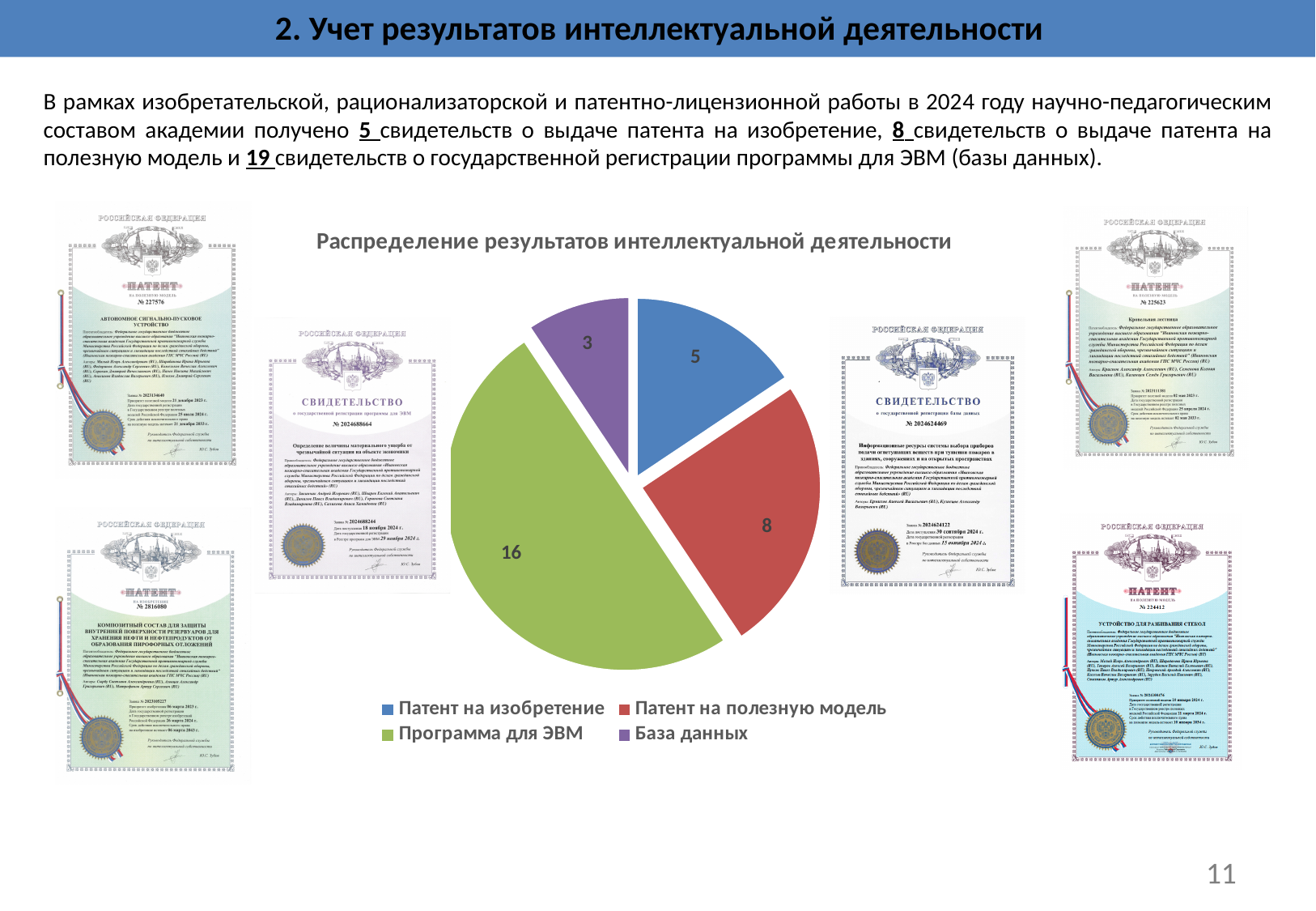
Which category has the smallest slice? База данных Which is larger, Патент на изобретение or Патент на полезную модель? Патент на полезную модель What kind of chart is shown on the slide? Pie chart What share of the pie does Программа для ЭВМ represent? 50% What is the value for Программа для ЭВМ? 16 What is the value for Патент на полезную модель? 8 What is the value for Патент на изобретение? 5 Which category has the largest slice? Программа для ЭВМ What is the difference between the values for Программа для ЭВМ and Патент на полезную модель? 8 What is the value for База данных? 3 How many slices does the pie chart have? 4 What is the title of the chart? Распределение результатов интеллектуальной деятельности